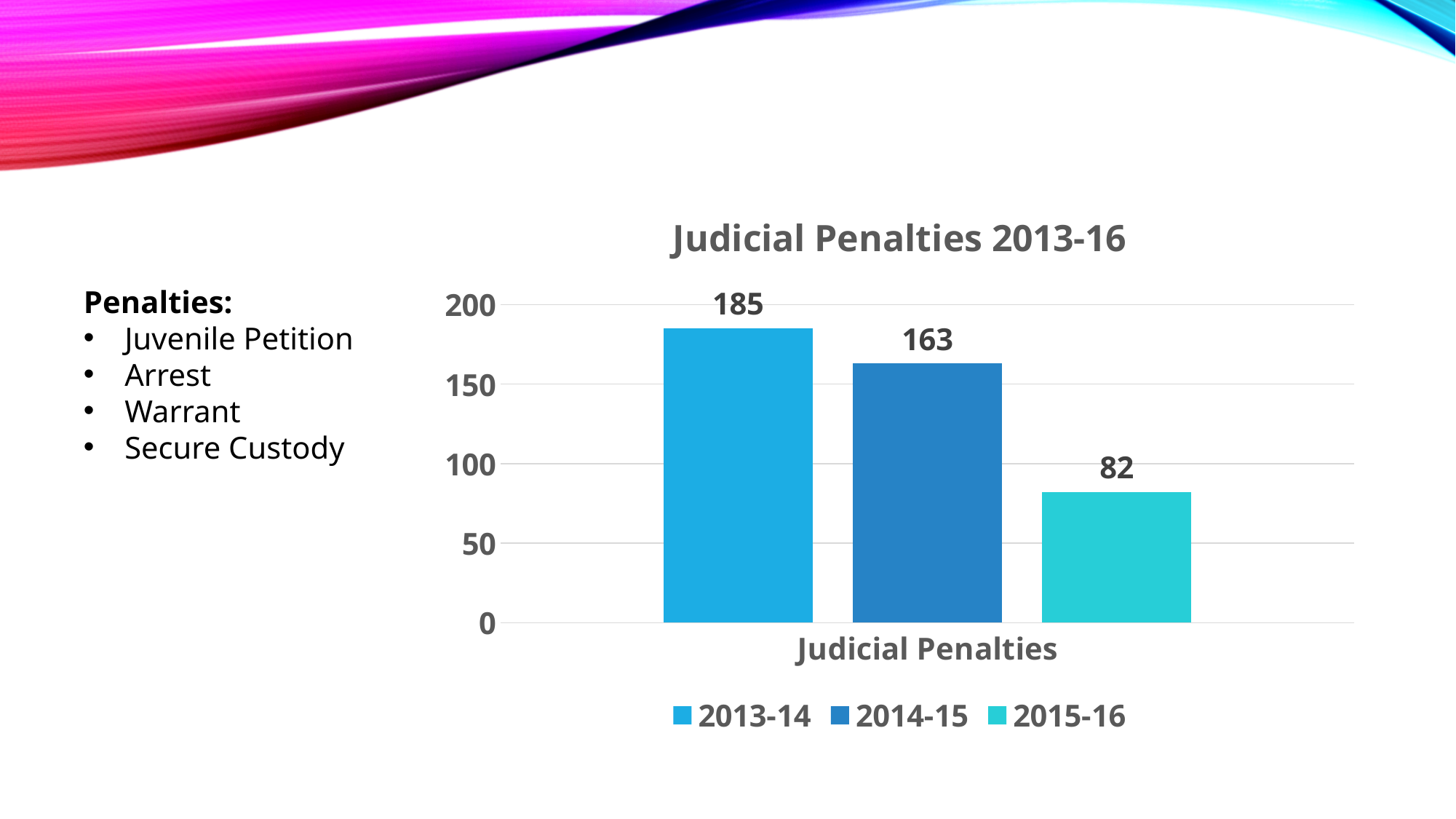
What is the value for 2013-14 in the Judicial Penalties 2013-16 chart? 185 Which series has the lowest value in the Judicial Penalties 2013-16 chart? 2015-16 What is the value for 2015-16 in the Judicial Penalties 2013-16 chart? 82 Which series has the highest value in the Judicial Penalties 2013-16 chart? 2013-14 What is the difference between the 2013-14 and 2015-16 values in the Judicial Penalties 2013-16 chart? 103 Do the values in the Judicial Penalties 2013-16 chart rise or fall from 2013-14 to 2015-16? fall What kind of chart is the Judicial Penalties 2013-16 chart? bar chart Which is larger in the Judicial Penalties 2013-16 chart, the value for 2014-15 or the value for 2015-16? 2014-15 What is the difference between the 2013-14 and 2014-15 values in the Judicial Penalties 2013-16 chart? 22 How many series does the legend of the Judicial Penalties 2013-16 chart list? 3 What is the value for 2014-15 in the Judicial Penalties 2013-16 chart? 163 Is the value for 2015-16 in the Judicial Penalties 2013-16 chart greater or less than 100? less